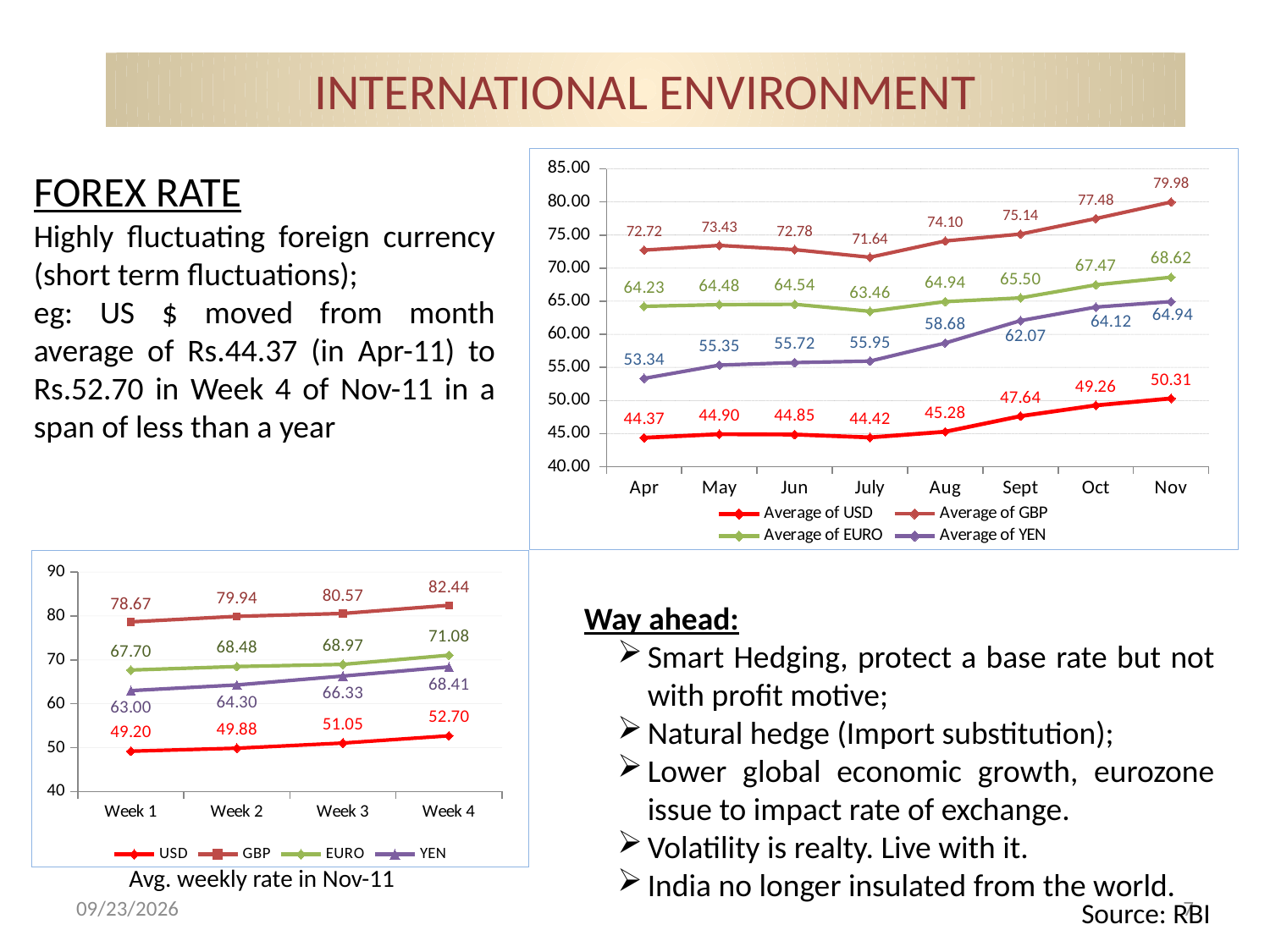
In the top-right monthly chart, what is the Average of YEN for Sept? 62.07 In the top-right monthly chart, what is the Average of GBP for Nov? 79.98 In the top-right monthly chart, how many series does the legend list? 4 In the bottom-left weekly chart, what is the EURO value for Week 2? 68.48 In the bottom-left weekly chart, what is the USD value for Week 4? 52.70 In the bottom-left weekly chart, which is larger in Week 3: GBP or EURO? GBP In the top-right monthly chart, does the Average of YEN rise or fall from Apr to Nov? rises In the top-right monthly chart, how many months are plotted on the x axis? 8 What type of chart is the bottom-left chart? line chart In the top-right monthly chart, what is the Average of USD for Apr? 44.37 In the top-right monthly chart, what is the difference between the Average of GBP in Nov and in Apr? 7.26 In the top-right monthly chart, in which month is the Average of EURO lowest? July